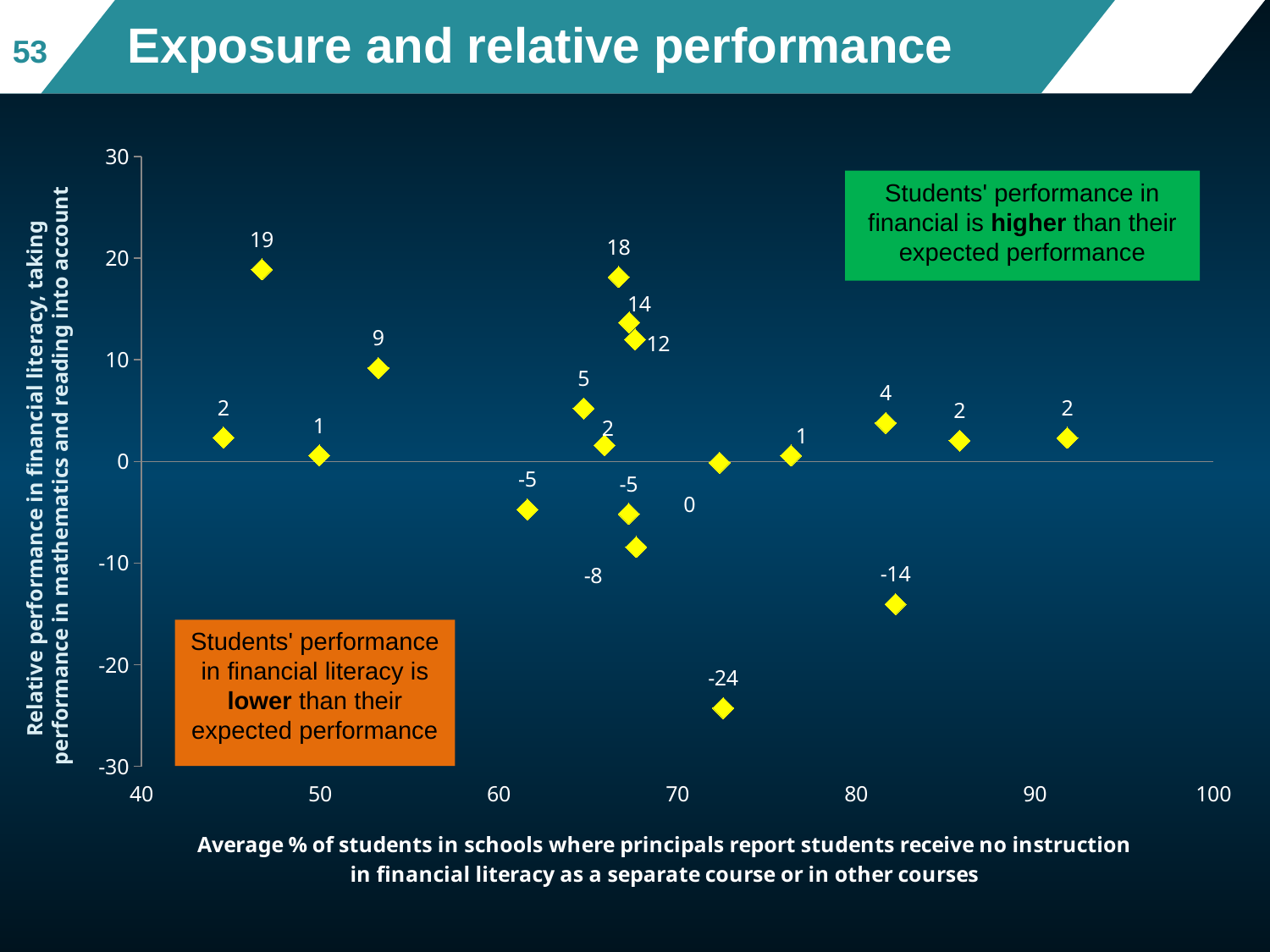
Is the x-axis value of the point labelled 19 greater or less than 50? less What is the highest relative performance value labelled on the chart? 19 What kind of chart is shown on the slide? scatter chart How many data points are plotted on the chart? 19 What is the highest tick value shown on the y-axis? 30 How many plotted points have a labelled value below 0? 5 What colour are the data point markers on the chart? yellow Is the x-axis value of the point labelled -14 greater or less than 80? greater How many plotted points have a labelled value above 10? 4 Which is larger, the value of the point labelled 18 or the point labelled 14? 18 What is the lowest relative performance value labelled on the chart? -24 What is the difference between the highest labelled value (19) and the lowest labelled value (-24)? 43